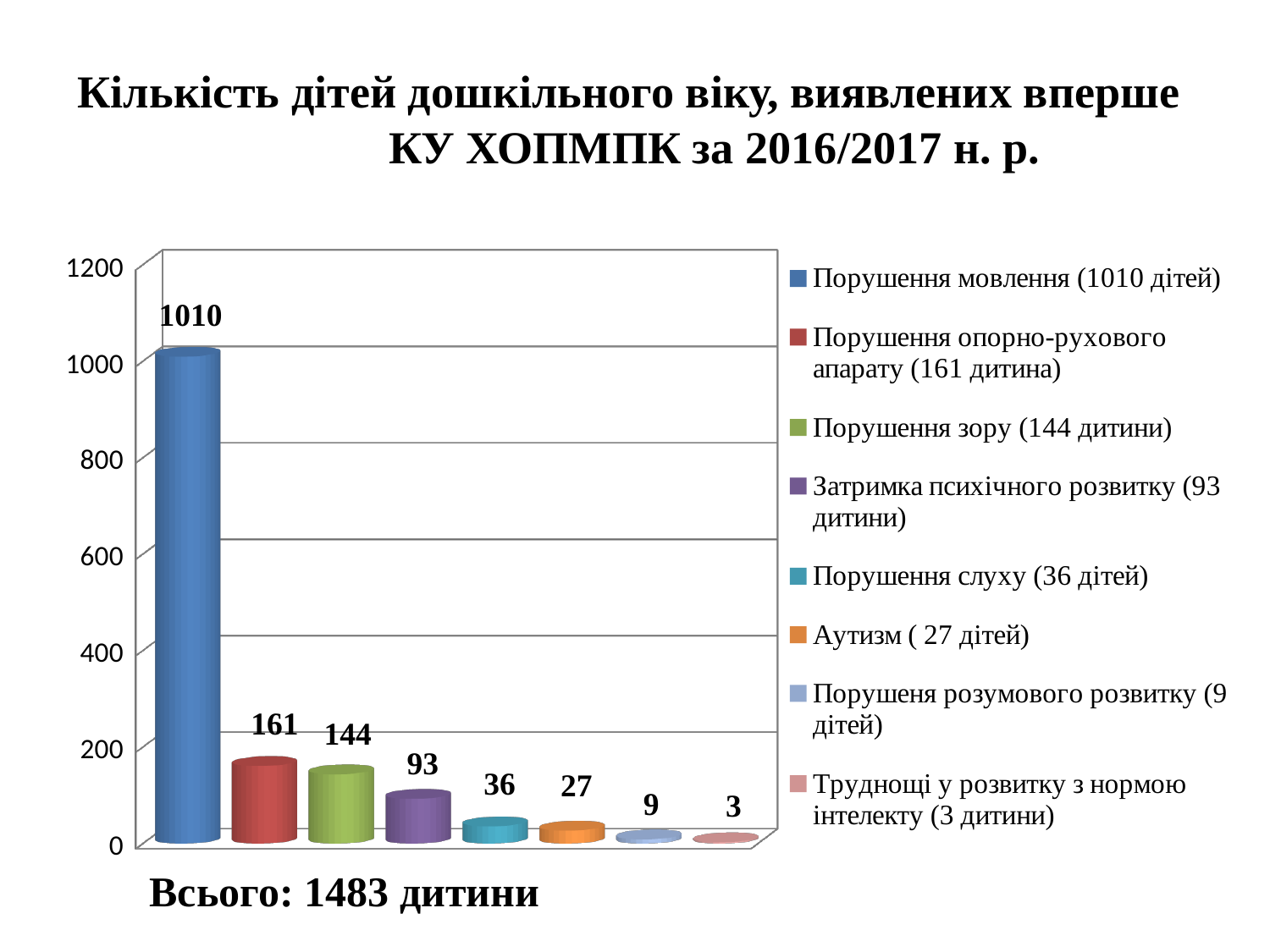
What type of chart is shown on the slide? bar chart Which category has the lowest value? Труднощі у розвитку з нормою інтелекту What is the value for Порушення зору? 144 Which is larger: the value for Затримка психічного розвитку or the value for Порушення слуху? Затримка психічного розвитку What total number of children is stated below the chart? 1483 дитини Do the values rise or fall from left to right along the x axis? fall What is the value for Порушення мовлення? 1010 What is the difference between the values for Порушення опорно-рухового апарату and Порушення зору? 17 How many bars are plotted in the chart? 8 Which category has the highest value? Порушення мовлення How many entries does the legend list? 8 What is the value for Аутизм? 27